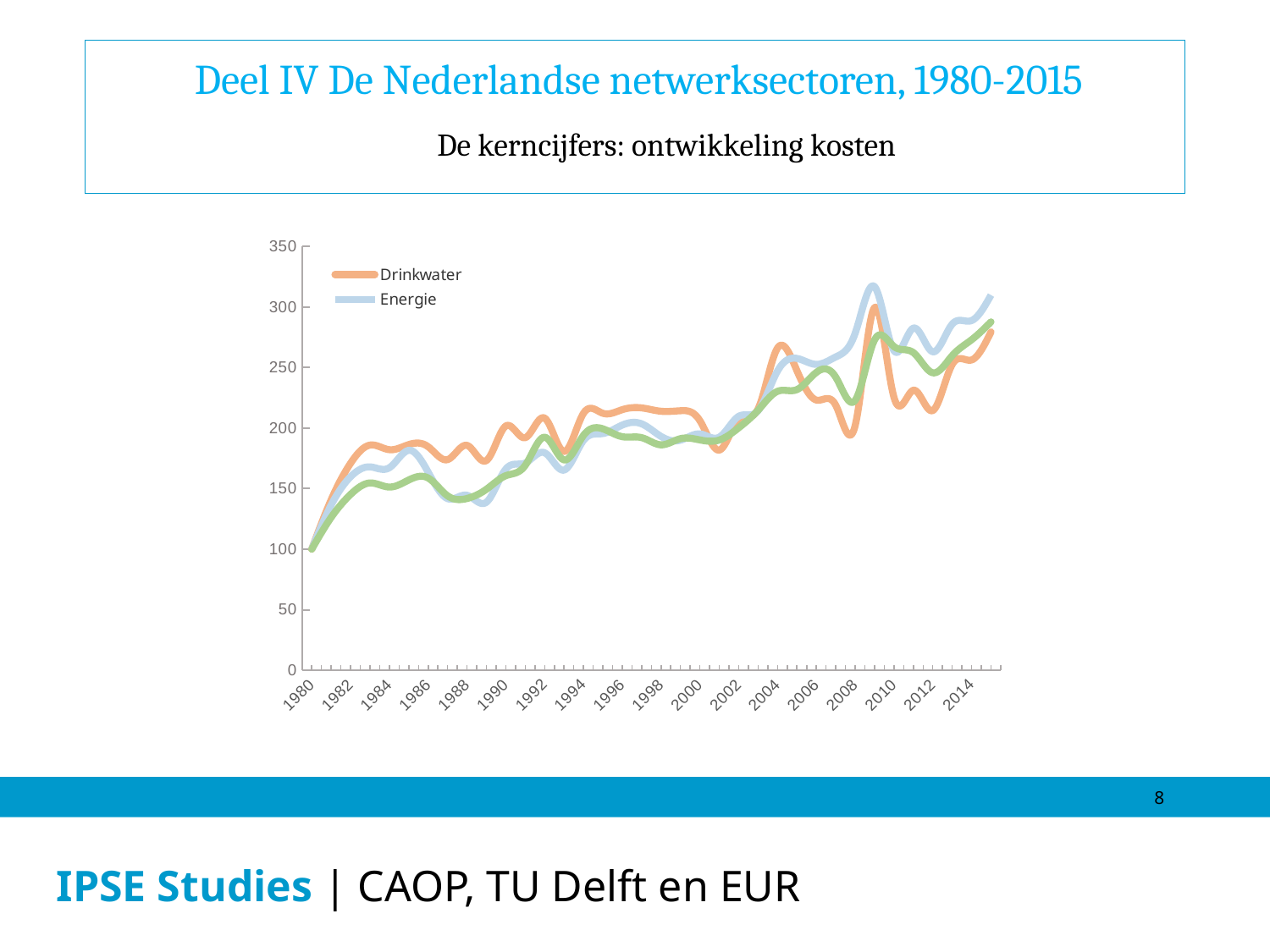
Is the value for Energie in 2009 greater or less than 300? greater Is the value for Drinkwater in 1988 greater or less than 150? greater Is the value for Drinkwater in 2012 greater or less than 250? less In 2012, which series has the higher value, Drinkwater or Energie? Energie What kind of chart is shown on the slide? line chart What colour is the Drinkwater line in the chart? orange In 1984, which series has the higher value, Drinkwater or Energie? Drinkwater How many series does the chart's legend list? 2 Which two series are named in the chart's legend? Drinkwater and Energie Overall, do the values for Energie rise or fall from 1980 to 2015? rise